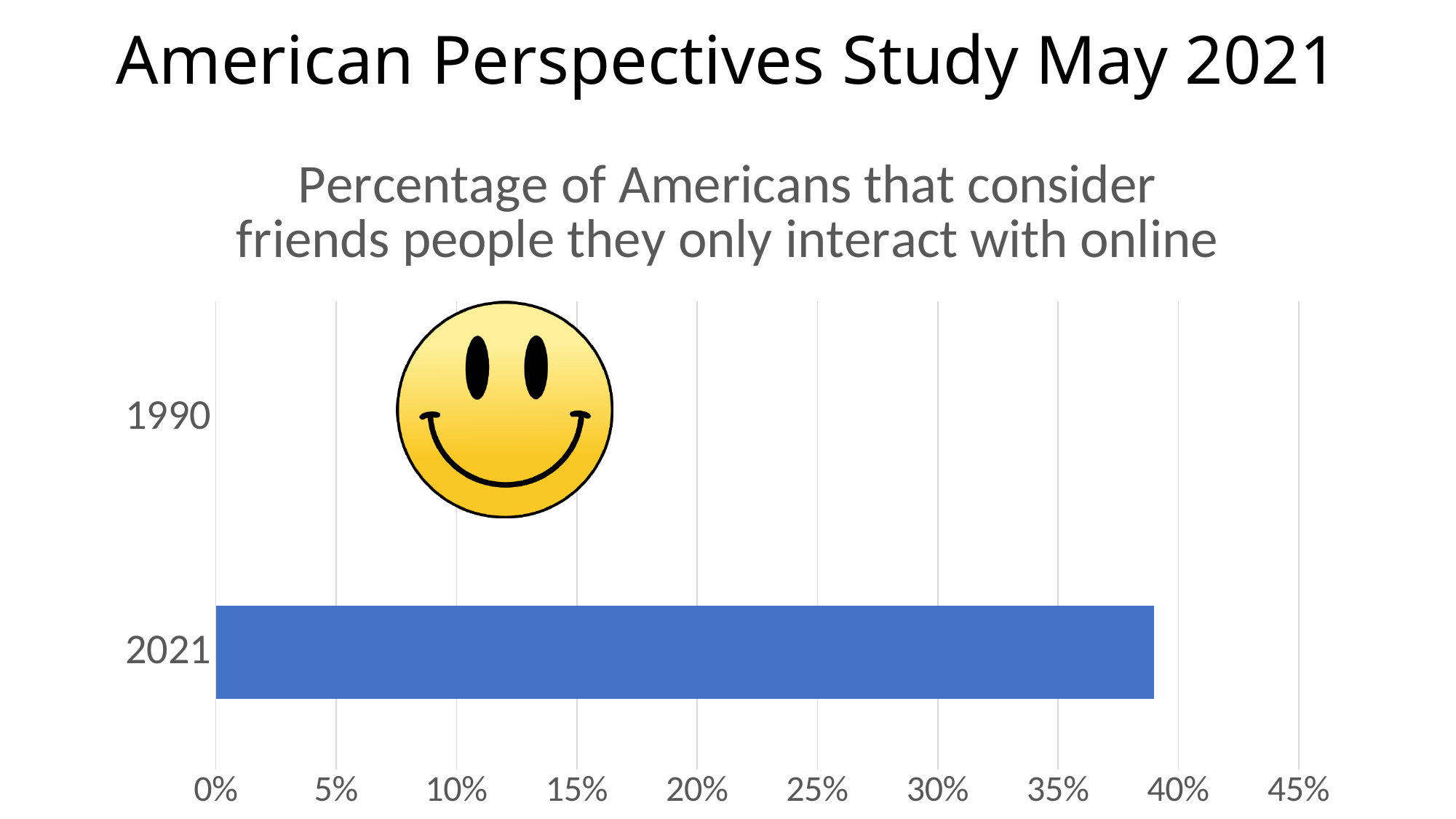
Which category has the highest value in the chart? 2021 Which category is listed first (at the top) on the vertical axis? 1990 What is the title of the chart? Percentage of Americans that consider friends people they only interact with online What is the highest value labelled on the horizontal axis of the chart? 45% What kind of chart is shown on the slide? bar chart Is the value for 2021 greater or less than 40%? less How many categories are shown on the vertical axis of the chart? 2 Is the value for 2021 greater or less than 20%? greater Which of the two categories, 1990 or 2021, has the larger value? 2021 Is the value for 2021 greater or less than 35%? greater